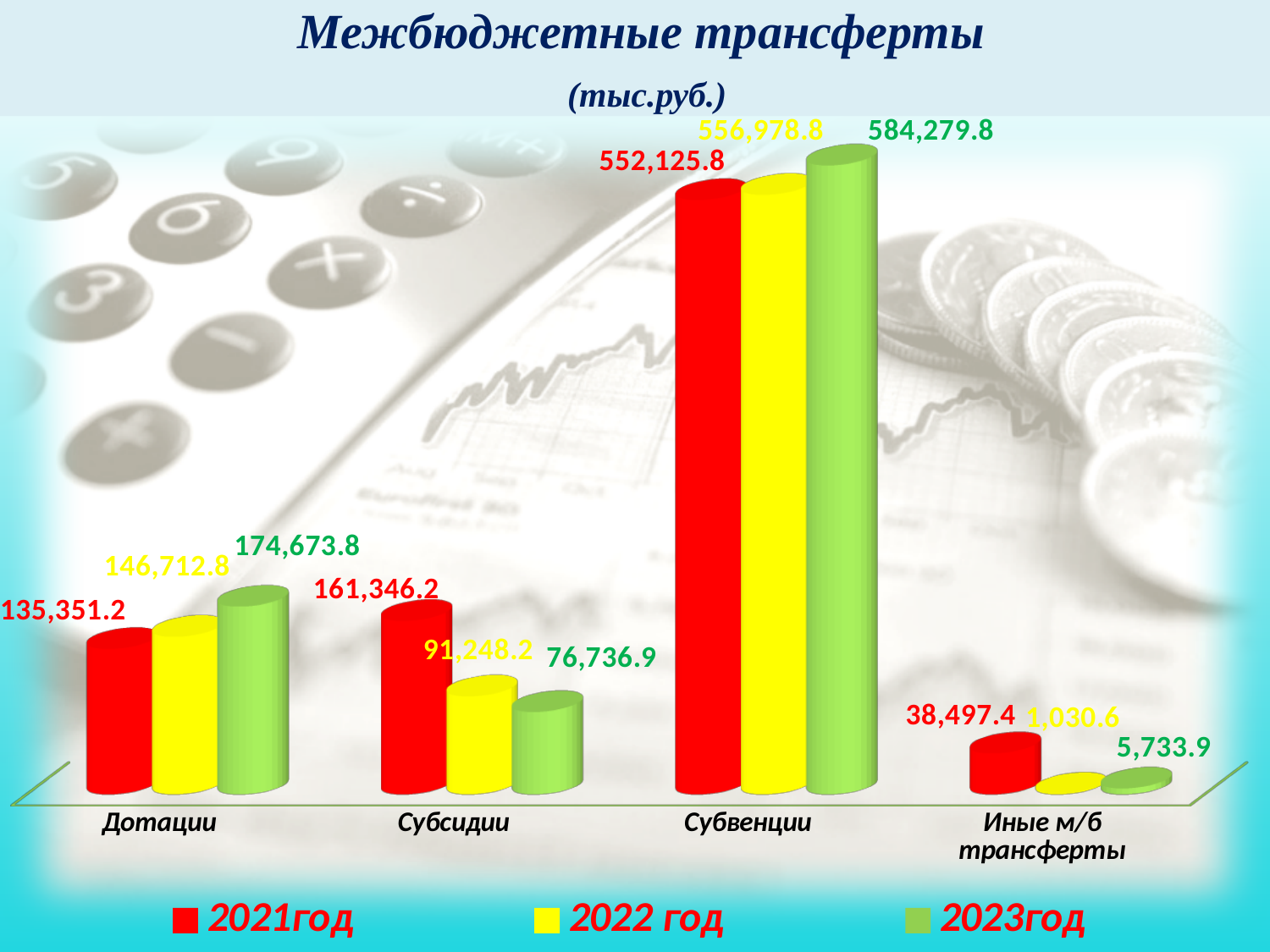
What kind of chart is shown on the slide? Bar chart Which is larger for Субсидии: the 2021год value or the 2022 год value? 2021год What is the difference between the 2023год and 2021год values for Дотации? 39,322.6 Which category has the highest value in 2022 год? Субвенции What is the value for Иные м/б трансферты in 2022 год? 1,030.6 How many series does the legend list? 3 What is the difference between the 2021год and 2023год values for Субсидии? 84,609.3 What is the value for Субвенции in 2023год? 584,279.8 How many categories are shown on the x axis? 4 What is the value for Субсидии in 2023год? 76,736.9 Which category has the lowest value in 2021год? Иные м/б трансферты What is the value for Дотации in 2021год? 135,351.2